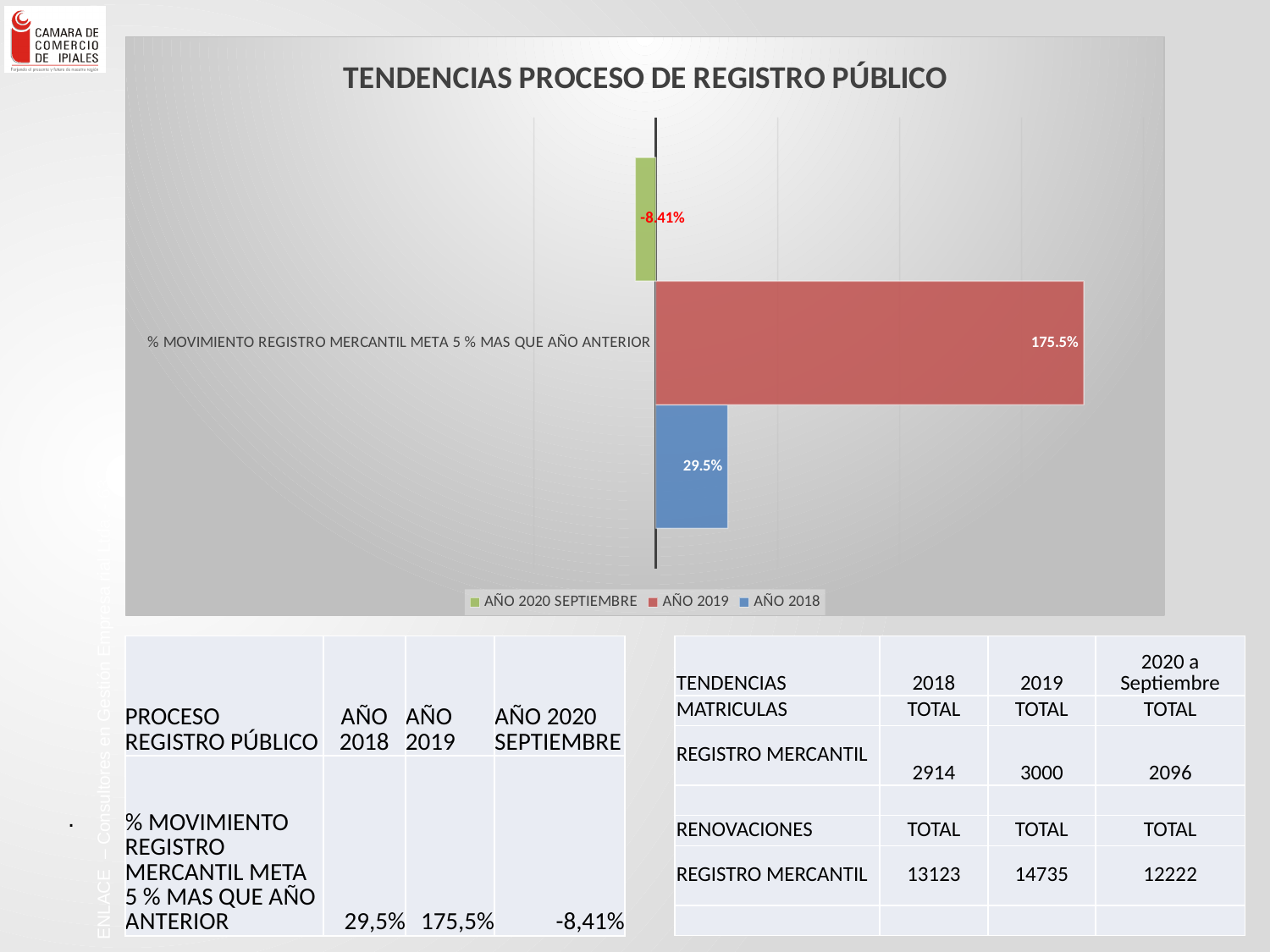
What is the difference between the AÑO 2019 value and the AÑO 2018 value? 146% Which series has the highest value in the chart? AÑO 2019 Which is larger, the value for AÑO 2018 or the value for AÑO 2020 SEPTIEMBRE? AÑO 2018 What kind of chart is shown on the slide? Bar chart How many categories are plotted on the chart's category axis? 1 Which series has the lowest value in the chart? AÑO 2020 SEPTIEMBRE What is the value for AÑO 2019 in the chart? 175.5% What is the value for AÑO 2020 SEPTIEMBRE in the chart? -8.41% Which series is shown in green in the chart? AÑO 2020 SEPTIEMBRE What is the value for AÑO 2018 in the chart? 29.5% How many series does the legend list? 3 What is the title of the chart? TENDENCIAS PROCESO DE REGISTRO PÚBLICO